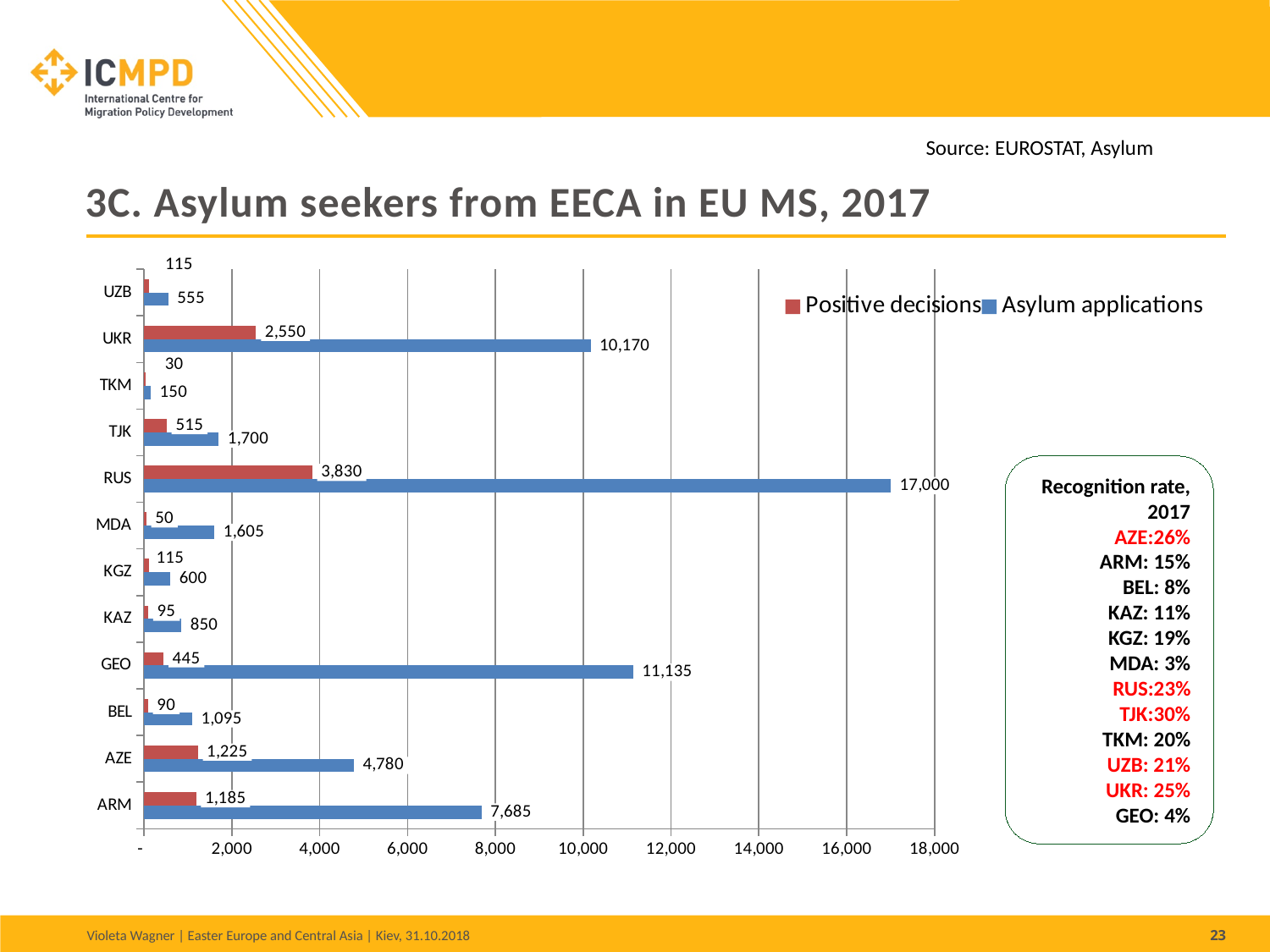
What is the difference between asylum applications and positive decisions for ARM? 6,500 Is the number of asylum applications for AZE greater or less than 4,000? greater Which country has the lowest number of asylum applications? TKM What is the number of asylum applications for GEO? 11,135 What kind of chart is shown on the slide? bar chart How many countries are shown on the chart? 12 How many series does the legend list? 2 What is the number of asylum applications for RUS? 17,000 What is the title of the chart? 3C. Asylum seekers from EECA in EU MS, 2017 Which has more asylum applications, UKR or GEO? GEO Which country has the highest number of asylum applications? RUS What is the number of positive decisions for UKR? 2,550